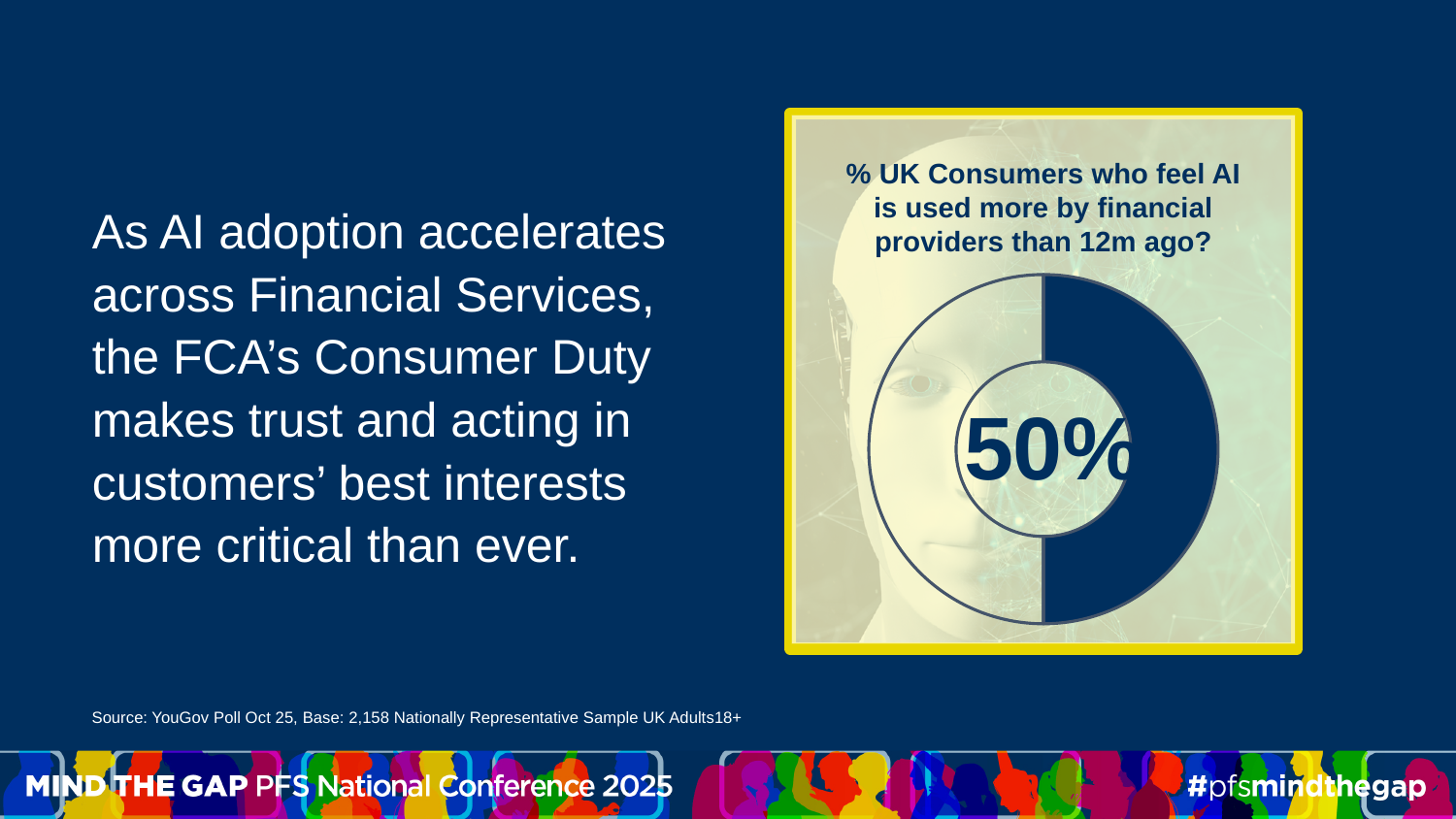
How many segments does the donut chart have? 2 Is the value shown in the donut chart greater or less than 25%? greater What share of UK consumers feel AI is used more by financial providers than 12 months ago, according to the chart? 50% What is the title of the chart on the slide? % UK Consumers who feel AI is used more by financial providers than 12m ago? What percentage is shown in the centre of the donut chart? 50% What kind of chart is shown on the slide? Donut (pie) chart Is the value shown in the donut chart greater or less than 75%? less What colour is the filled segment of the donut chart? Dark blue